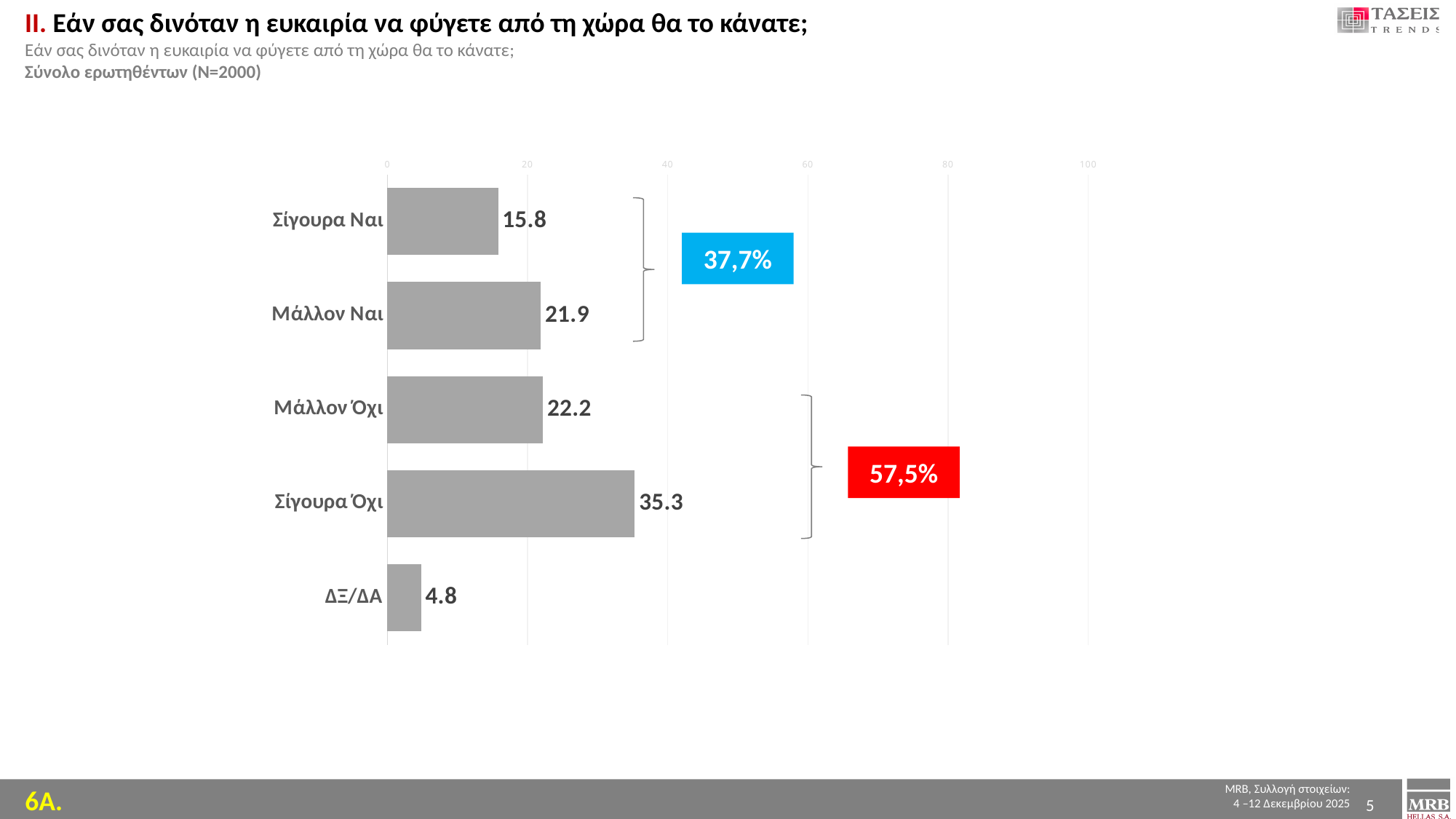
What is the value for Σίγουρα Όχι? 35.3 What is the value for Σίγουρα Ναι? 15.8 What is the difference between the values for Σίγουρα Όχι and Σίγουρα Ναι? 19.5 Which category has the highest value? Σίγουρα Όχι What kind of chart is shown on the slide? Bar chart Which category has the lowest value? ΔΞ/ΔΑ Which is larger, the value for Σίγουρα Όχι or the value for Μάλλον Όχι? Σίγουρα Όχι How many categories are shown in the chart? 5 What combined percentage is shown in the blue box for the Σίγουρα Ναι and Μάλλον Ναι bars? 37,7% What is the value for Μάλλον Ναι? 21.9 What is the value for ΔΞ/ΔΑ? 4.8 What is the value for Μάλλον Όχι? 22.2